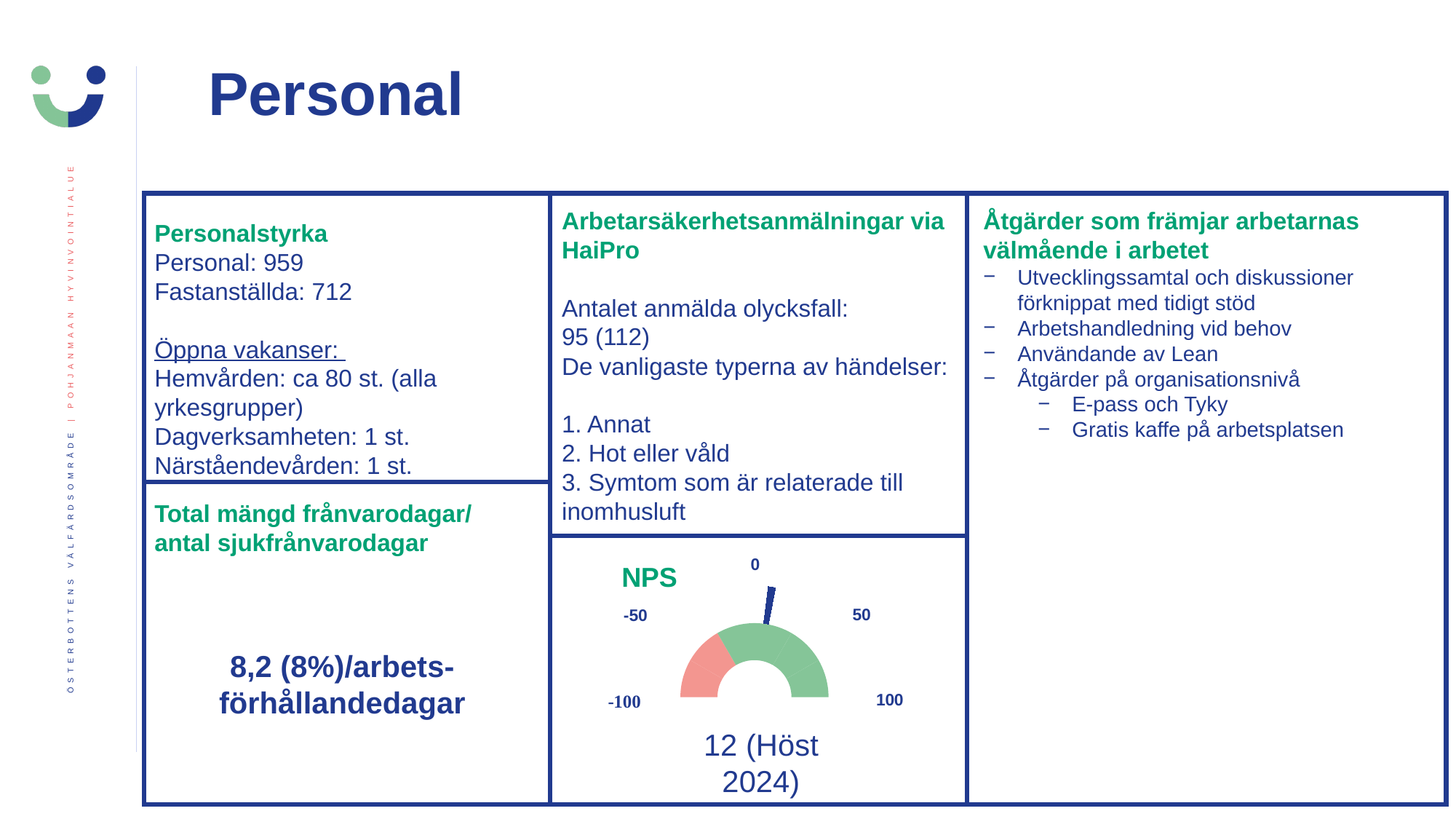
What NPS value is printed below the gauge chart? 12 (Höst 2024) What is the highest tick label on the NPS gauge scale? 100 What is the lowest tick label on the NPS gauge scale? -100 Which colour is used for the negative (left) portion of the NPS gauge? red Is the NPS value shown on the gauge greater or less than 50? less Is the NPS value shown on the gauge greater or less than 0? greater For which period is the NPS value on the gauge reported? Höst 2024 What is the title of the gauge chart? NPS What kind of chart is shown in the NPS panel? gauge chart How many tick labels are printed around the NPS gauge? 5